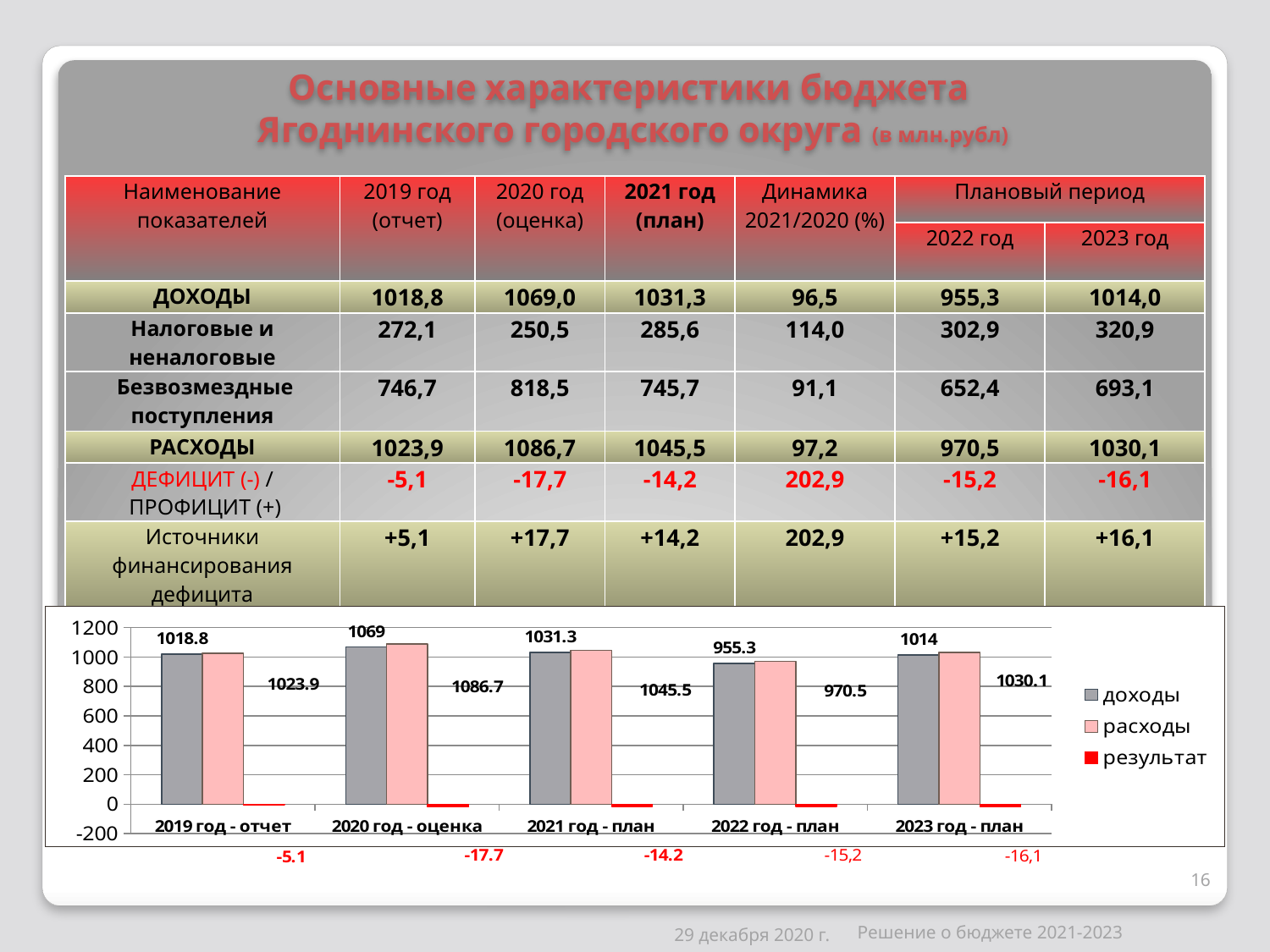
What kind of chart is shown at the bottom of the slide? bar chart How many series does the chart legend list? 3 How many year categories are shown on the x axis of the chart? 5 In which year category is доходы the highest in the chart? 2020 год - оценка What is the value of расходы for 2020 год - оценка in the chart? 1086.7 What is the difference between расходы and доходы for 2019 год - отчет in the chart? 5.1 What is the value of доходы for 2022 год - план in the chart? 955.3 Which series in the chart is shown in red? результат Which is larger in the chart for 2023 год - план: доходы or расходы? расходы Is the value of доходы for 2022 год - план greater or less than 1000 in the chart? less What is the value of доходы for 2021 год - план in the chart? 1031.3 In which year category is расходы the lowest in the chart? 2022 год - план